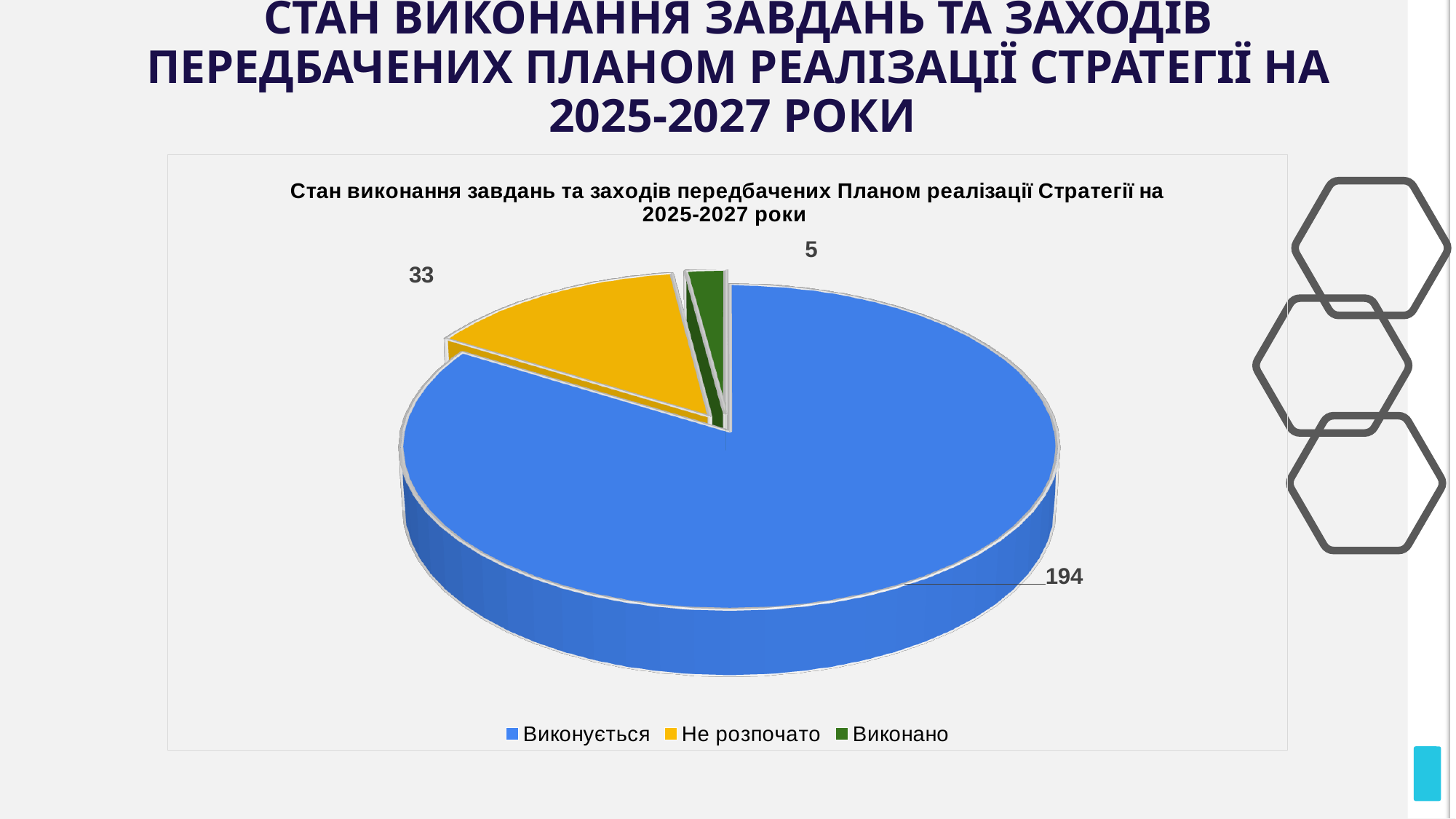
Which category has the largest slice of the pie? Виконується What is the total of all slices in the pie chart? 232 What is the value for the 'Не розпочато' slice? 33 What type of chart is shown on the slide? Pie chart Which category has the smallest slice of the pie? Виконано What is the value for the 'Виконується' slice? 194 What is the difference between the 'Не розпочато' and 'Виконано' values? 28 How many categories does the pie chart have? 3 What colour is the 'Не розпочато' slice? Yellow What is the difference between the 'Виконується' and 'Не розпочато' values? 161 What is the value for the 'Виконано' slice? 5 Which is larger: 'Не розпочато' or 'Виконано'? Не розпочато